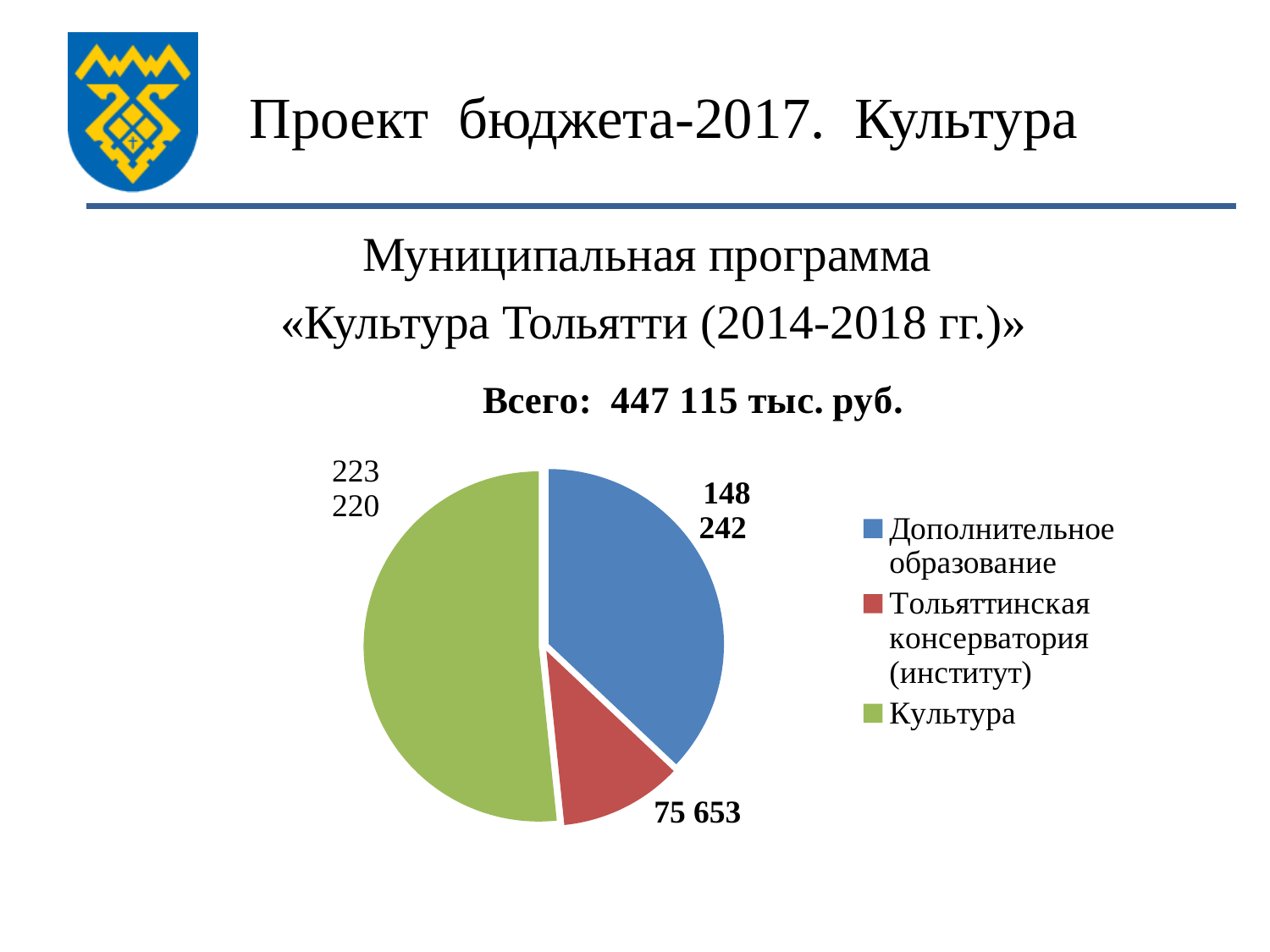
What share of the pie does the Культура slice represent, to the nearest whole percent? 50% Which is larger: the value for Дополнительное образование or the value for Тольяттинская консерватория (институт)? Дополнительное образование What value is shown for the Дополнительное образование slice? 148 242 What is the difference between the values for Дополнительное образование and Тольяттинская консерватория (институт)? 72 589 Which category has the smallest slice of the pie? Тольяттинская консерватория (институт) Which category has the largest slice of the pie? Культура How many slices does the pie chart have? 3 What kind of chart is shown on the slide? Pie chart What colour is the Культура slice in the pie chart? Green What value is shown for the Тольяттинская консерватория (институт) slice? 75 653 What value is shown for the Культура slice? 223 220 What is the difference between the values for Культура and Дополнительное образование? 74 978